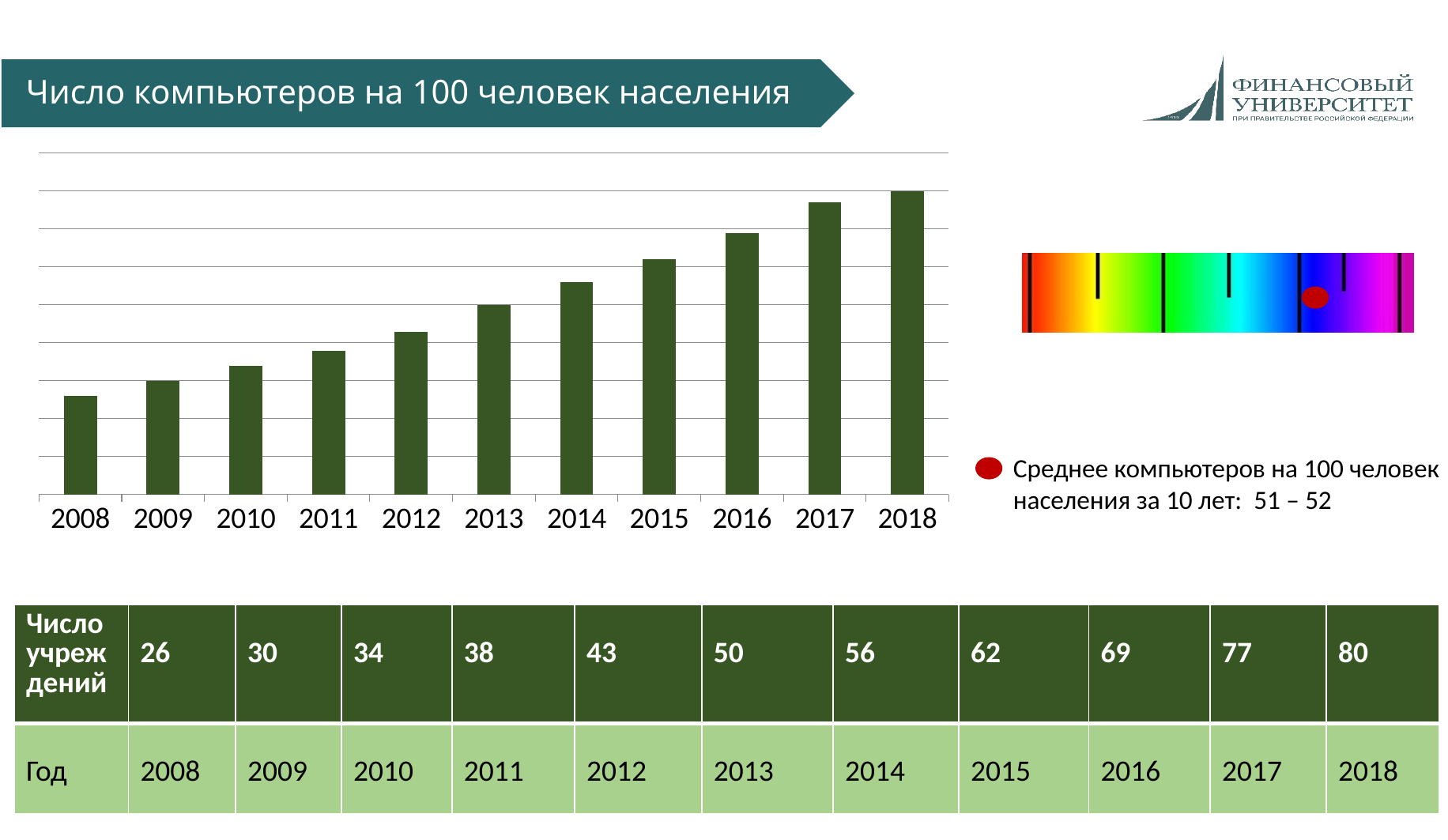
What average number of computers per 100 people over 10 years is stated next to the red dot? 51 – 52 How many years are plotted on the x axis of the chart? 11 Using the table values, what is the difference between the 2018 value and the 2008 value? 54 What is the title of the chart? Число компьютеров на 100 человек населения According to the table under the chart, what is the value for 2016? 69 Which year has the lowest bar in the chart? 2008 Which year has the highest bar in the chart? 2018 Which year has the larger bar, 2012 or 2015? 2015 According to the table under the chart, what is the value for 2018? 80 According to the table under the chart, what is the value for 2013? 50 Do the bar values rise or fall from 2008 to 2018? rise What kind of chart is shown on the slide? bar chart